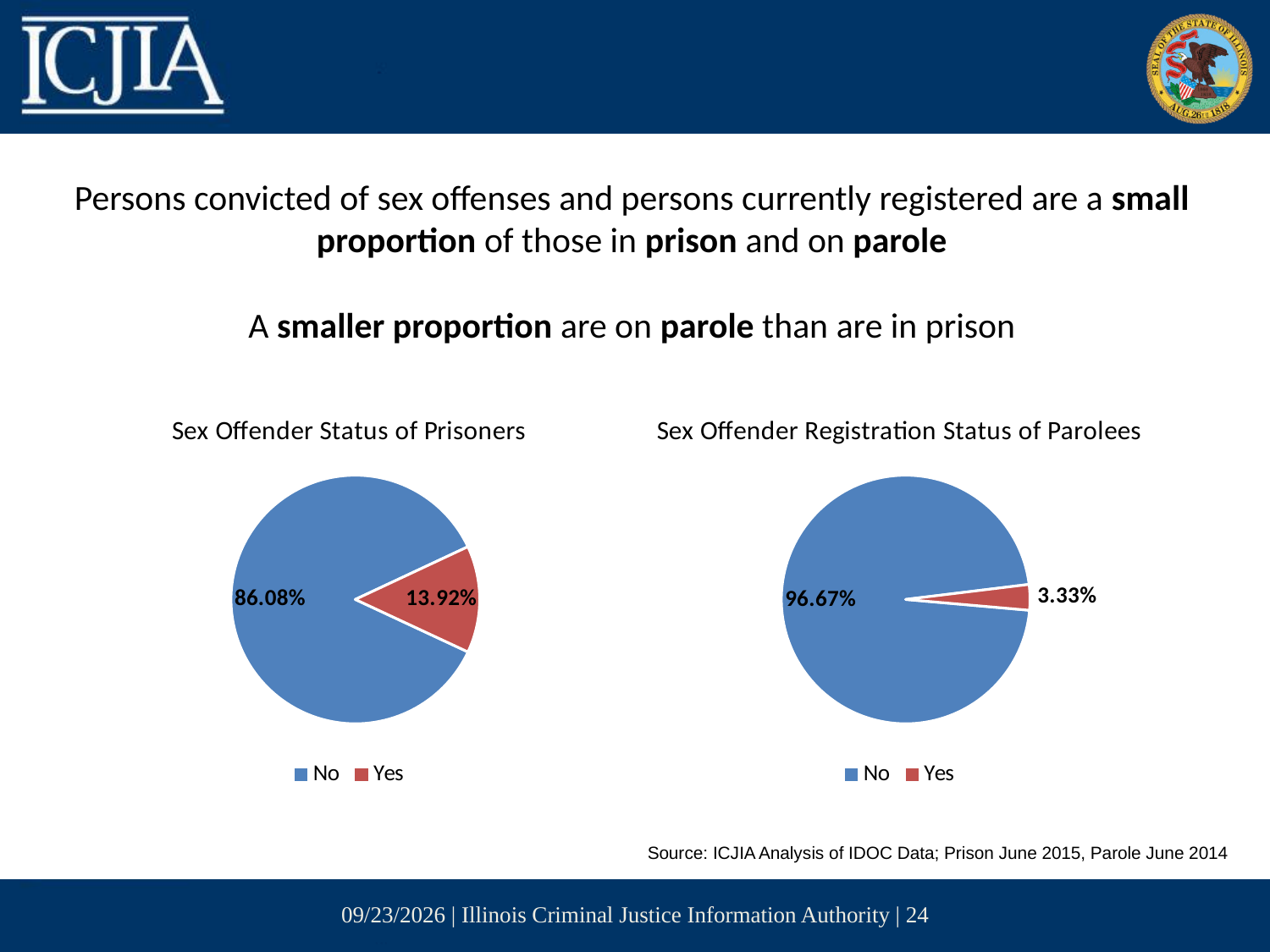
How many slices does the 'Sex Offender Registration Status of Parolees' chart have? 2 In the 'Sex Offender Status of Prisoners' chart, which slice is the largest? No In the 'Sex Offender Registration Status of Parolees' chart, what colour is the 'Yes' slice? Red In the 'Sex Offender Registration Status of Parolees' chart, what percentage is labelled for the 'Yes' slice? 3.33% In the 'Sex Offender Status of Prisoners' chart, what percentage is labelled for the 'No' slice? 86.08% In the 'Sex Offender Registration Status of Parolees' chart, what percentage is labelled for the 'No' slice? 96.67% What is the difference between the 'No' and 'Yes' percentages in the 'Sex Offender Status of Prisoners' chart? 72.16% In the 'Sex Offender Registration Status of Parolees' chart, which slice is the smallest? Yes How many entries does the legend of the 'Sex Offender Status of Prisoners' chart list? 2 In the 'Sex Offender Status of Prisoners' chart, what percentage is labelled for the 'Yes' slice? 13.92% What type of chart is the 'Sex Offender Status of Prisoners' chart? Pie chart Which is larger: the 'Yes' share in the 'Sex Offender Status of Prisoners' chart or the 'Yes' share in the 'Sex Offender Registration Status of Parolees' chart? Sex Offender Status of Prisoners